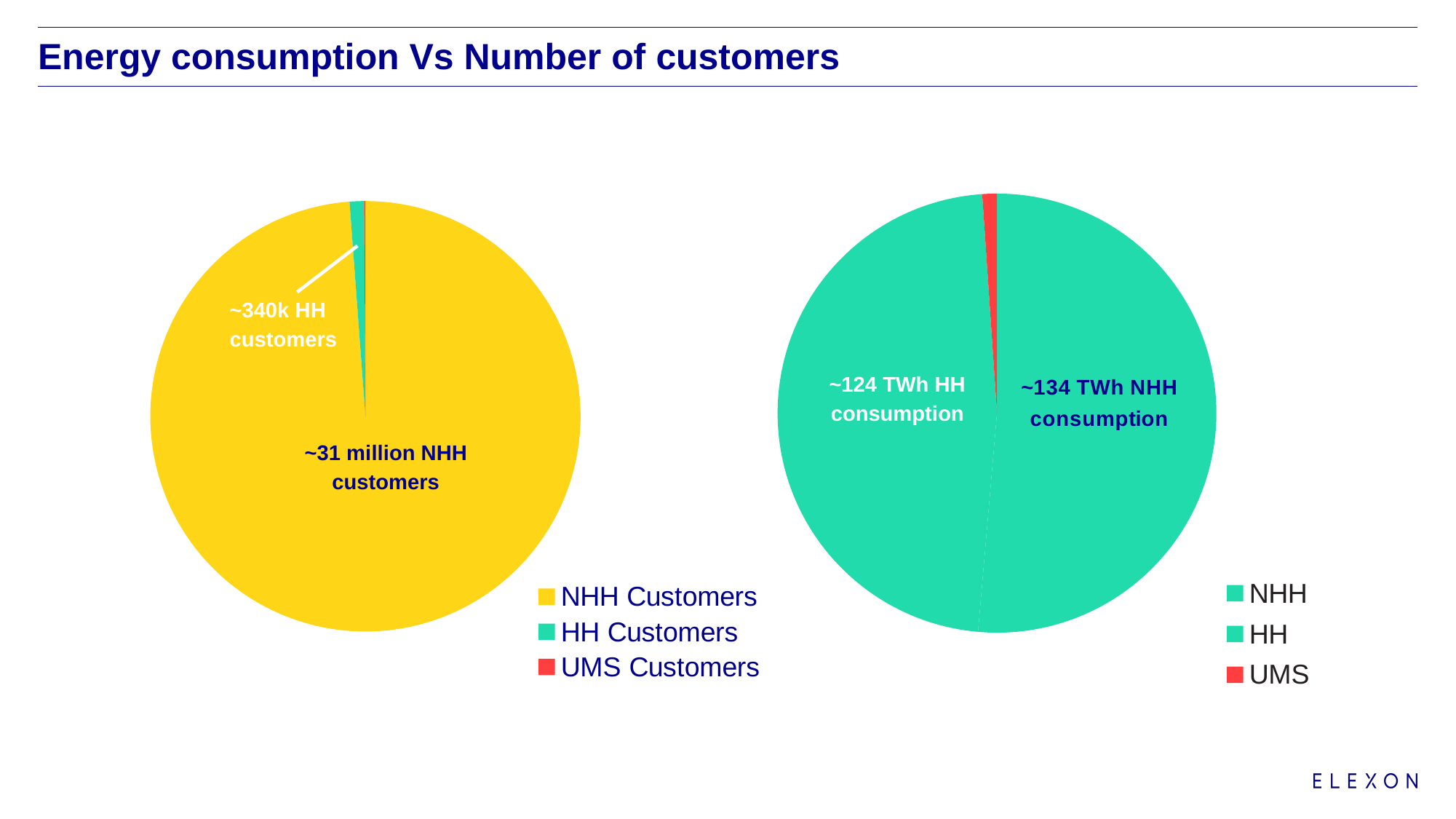
How many entries does the legend of the right pie chart list? 3 What type of charts are shown on the slide? Pie charts In the left pie chart, what is the labelled number of HH customers? ~340k What colour represents UMS in both pie charts? Red In the right pie chart, which is larger: NHH consumption or HH consumption? NHH consumption In the left pie chart, which category has the largest slice? NHH Customers In the right pie chart, what is the labelled NHH consumption? ~134 TWh How many entries does the legend of the left pie chart list? 3 In the right pie chart, what is the labelled HH consumption? ~124 TWh In the right pie chart, which category has the smallest slice? UMS In the left pie chart, which is larger: NHH customers or HH customers? NHH customers In the left pie chart, what is the labelled number of NHH customers? ~31 million